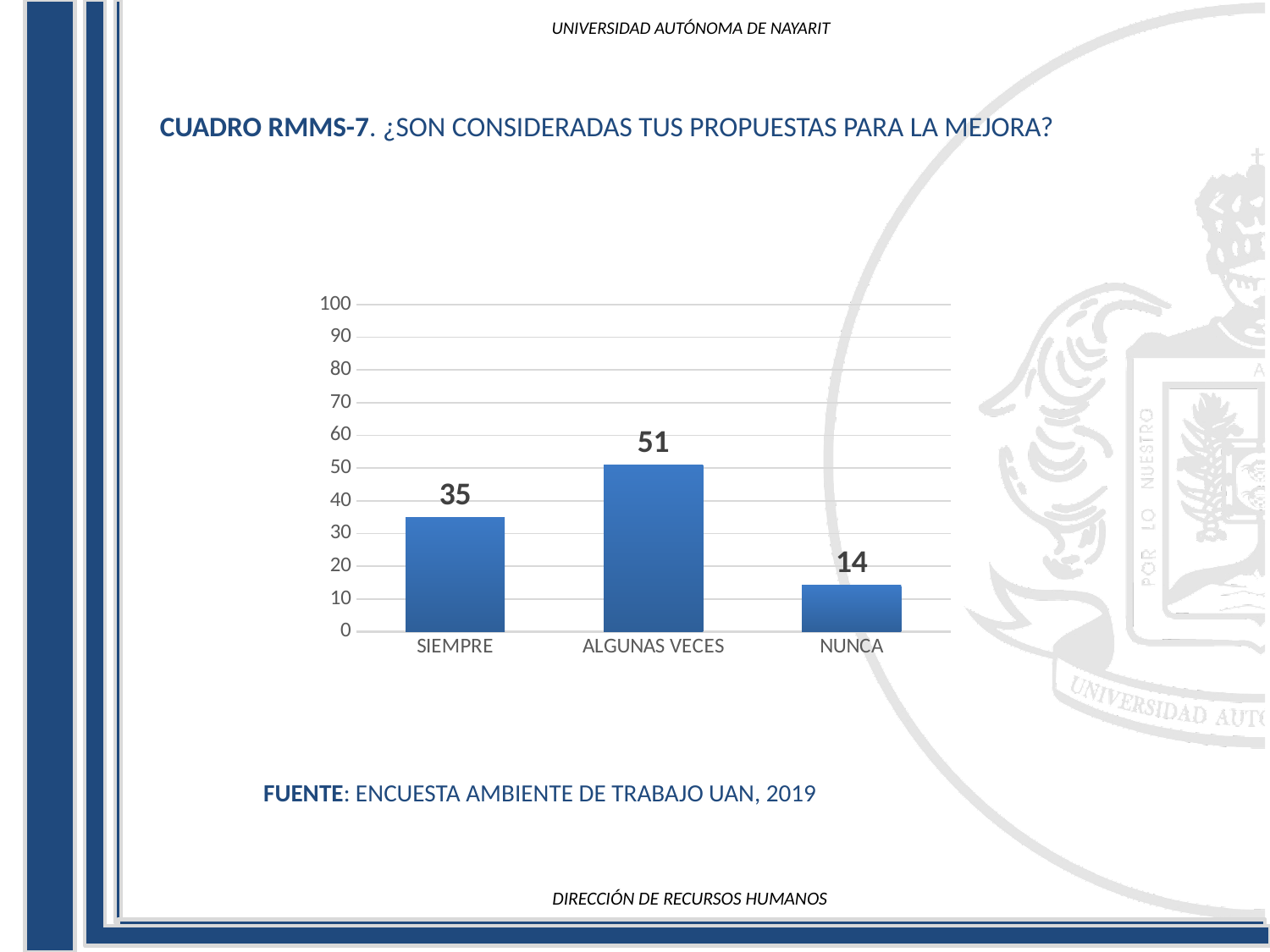
What is the highest value shown on the vertical axis? 100 Which is larger, the value for SIEMPRE or the value for NUNCA? SIEMPRE Which category has the lowest value? NUNCA What is the value for NUNCA? 14 Which category has the highest value? ALGUNAS VECES What is the value for ALGUNAS VECES? 51 Is the value for ALGUNAS VECES greater or less than 60? less What kind of chart is shown on the slide? bar chart What is the difference between the values for ALGUNAS VECES and SIEMPRE? 16 How many categories are shown on the x axis? 3 What is the difference between the values for SIEMPRE and NUNCA? 21 What is the value for SIEMPRE? 35